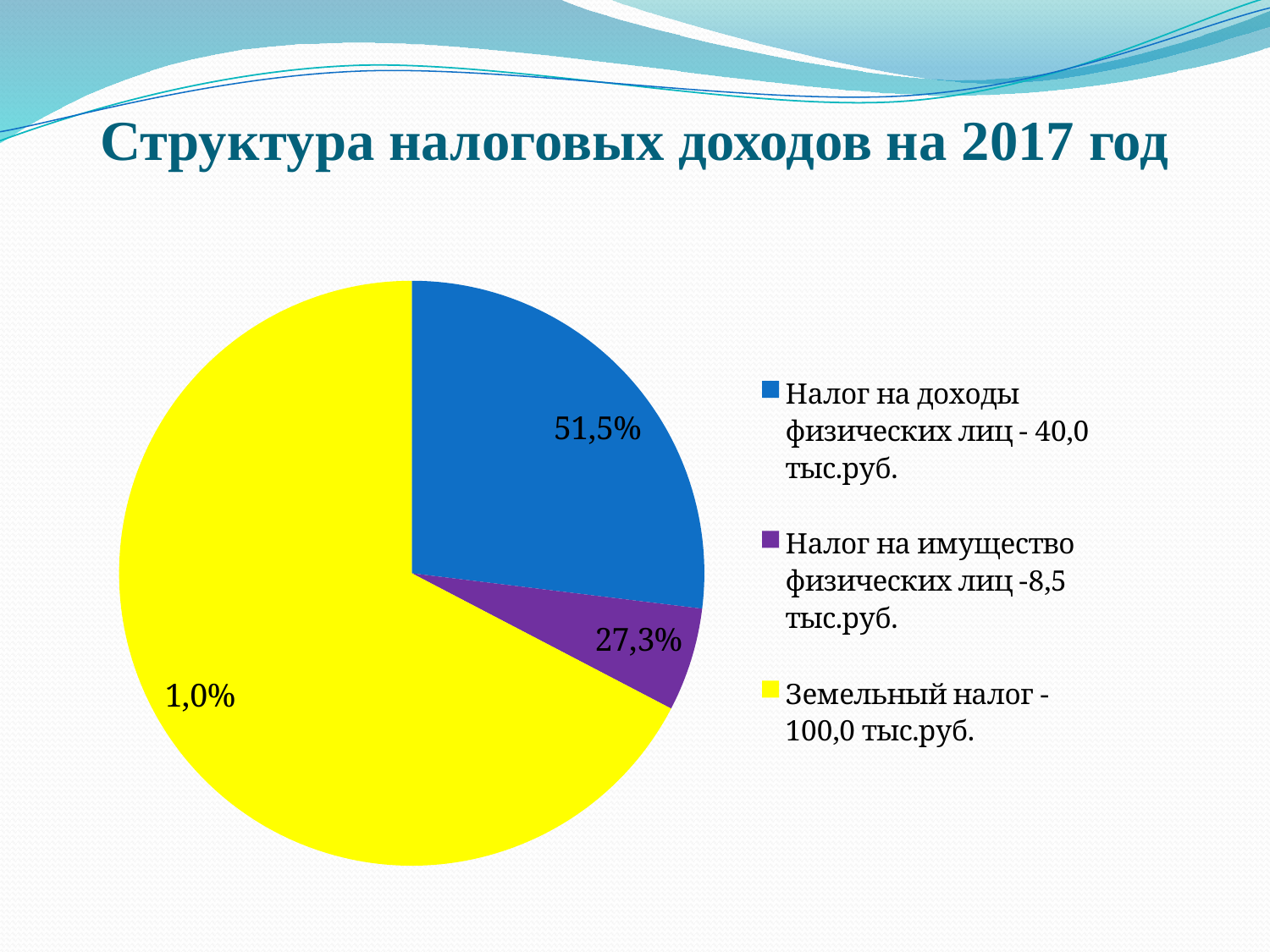
What type of chart is shown on the slide? pie chart What percentage label is printed on the purple slice? 27,3% What percentage label is printed on the blue slice? 51,5% Which category has the largest slice of the pie? Земельный налог By how much does the legend amount for Земельный налог exceed that for Налог на доходы физических лиц? 60,0 тыс.руб. Which colour represents Земельный налог in the pie chart? yellow What is the title of the chart on the slide? Структура налоговых доходов на 2017 год How many slices does the pie chart have? 3 What amount does the legend give for Налог на имущество физических лиц? 8,5 тыс.руб. What amount does the legend give for Земельный налог? 100,0 тыс.руб. Which category has the smallest slice of the pie? Налог на имущество физических лиц What amount does the legend give for Налог на доходы физических лиц? 40,0 тыс.руб.